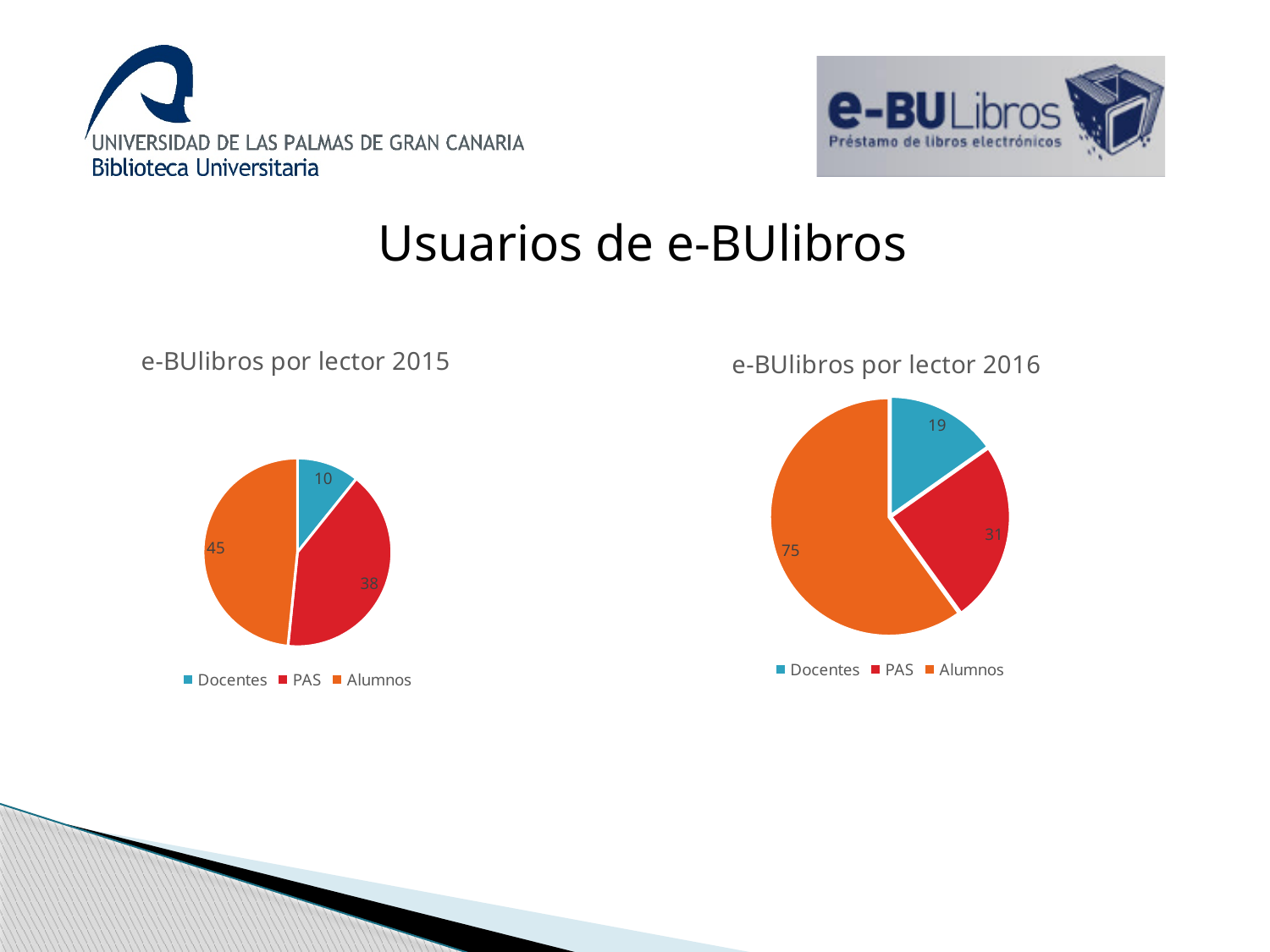
How many categories does the chart titled "e-BUlibros por lector 2016" show? 3 In the chart titled "e-BUlibros por lector 2016", what is the value for Docentes? 19 In the chart titled "e-BUlibros por lector 2015", which is larger, the value for PAS or the value for Docentes? PAS In the chart titled "e-BUlibros por lector 2015", what is the value for PAS? 38 In the chart titled "e-BUlibros por lector 2016", which category has the largest slice? Alumnos In the chart titled "e-BUlibros por lector 2015", what is the value for Alumnos? 45 What kind of chart is the chart titled "e-BUlibros por lector 2015"? Pie chart In the chart titled "e-BUlibros por lector 2015", which category has the smallest slice? Docentes Which colour represents PAS in the legend of the chart titled "e-BUlibros por lector 2016"? Red In the chart titled "e-BUlibros por lector 2016", what is the difference between the values for Alumnos and PAS? 44 In the chart titled "e-BUlibros por lector 2016", what share of the total do Alumnos represent? 60% What is the total of all slices in the chart titled "e-BUlibros por lector 2015"? 93